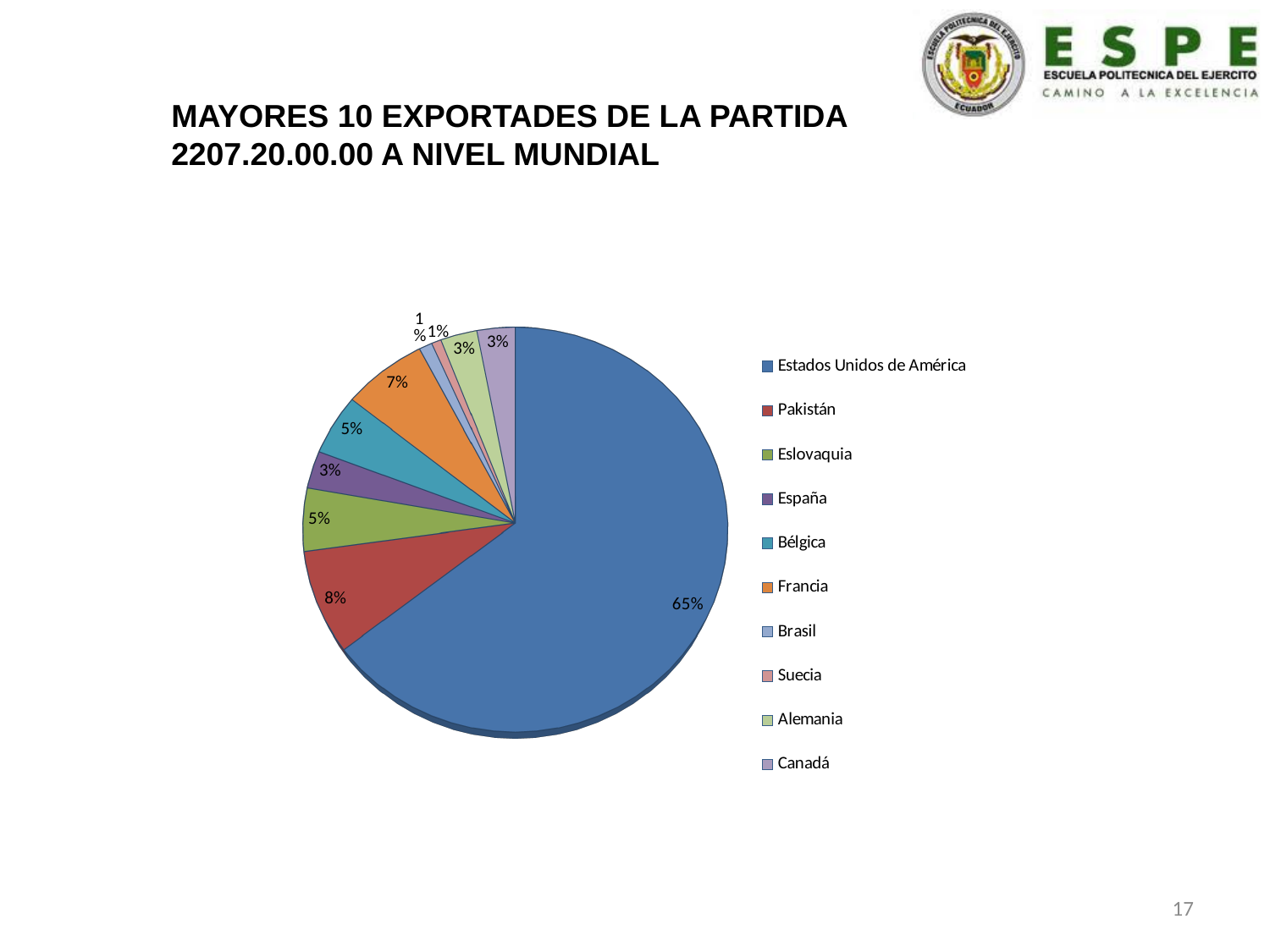
Which country has the largest slice of the pie? Estados Unidos de América What share of the pie does Estados Unidos de América hold? 65% What is the value shown for Canadá? 3% Which has a larger share, Francia or Eslovaquia? Francia How many countries are listed in the legend? 10 What is the combined share of Brasil and Suecia? 2% What type of chart is shown on the slide? pie chart What is the difference between the shares of Estados Unidos de América and Pakistán? 57% What is the value shown for Francia? 7% What is the value shown for Pakistán? 8% What is the value shown for Bélgica? 5% Which country is listed last in the legend? Canadá